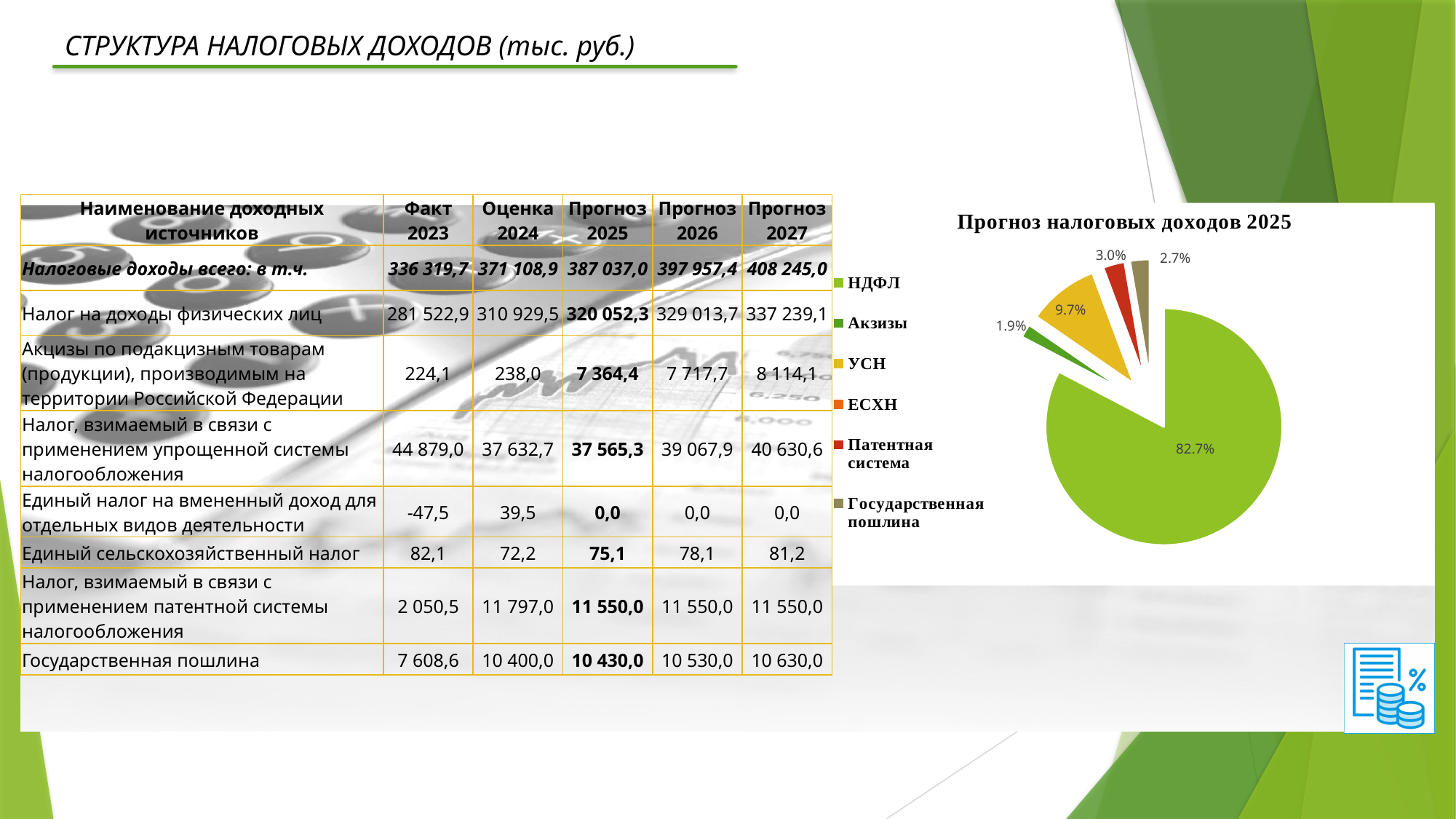
In the pie chart, what share is shown for УСН? 9.7% What kind of chart is shown on the slide? pie chart In the pie chart, which slice is larger: УСН or Патентная система? УСН How many categories does the legend of the pie chart list? 6 In the pie chart, what share is shown for Патентная система? 3.0% In the pie chart, which slice is larger: Акцизы or Государственная пошлина? Государственная пошлина In the pie chart, what share is shown for Акцизы? 1.9% Which category has the largest slice in the pie chart? НДФЛ In the pie chart, what share is shown for Государственная пошлина? 2.7% In the pie chart, what is the difference in percentage points between the НДФЛ share and the УСН share? 73.0 In the pie chart, what share is shown for НДФЛ? 82.7% What is the title of the pie chart? Прогноз налоговых доходов 2025